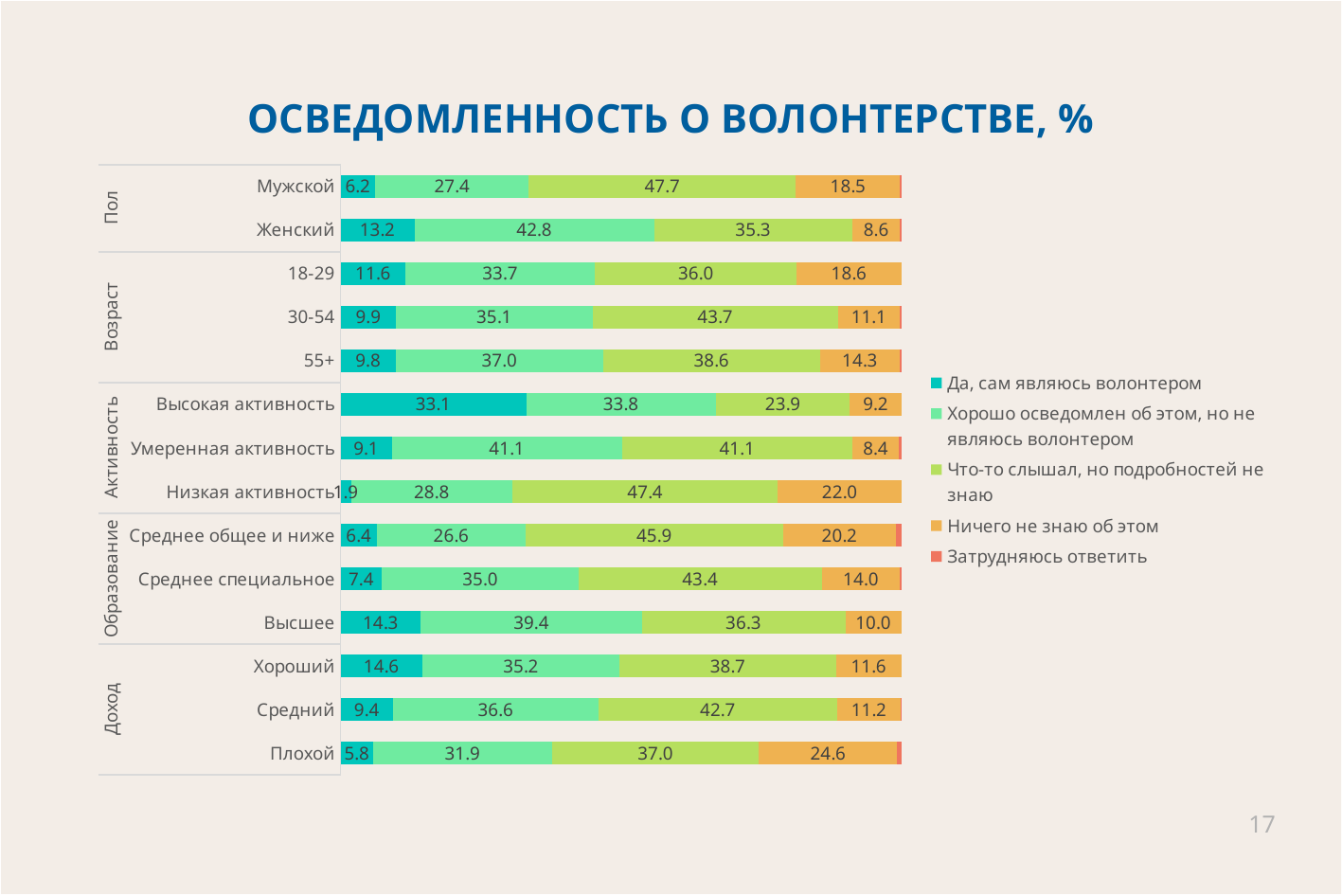
Which category has the lowest value for "Да, сам являюсь волонтером"? Низкая активность Which category has the highest value for "Да, сам являюсь волонтером"? Высокая активность What is the value of "Хорошо осведомлен об этом, но не являюсь волонтером" for "Женский"? 42.8 What kind of chart is shown on the slide? bar chart How many category bars are plotted in the chart? 14 What is the value of "Да, сам являюсь волонтером" for "Высокая активность"? 33.1 How many series does the legend list? 5 What is the value of "Ничего не знаю об этом" for "Плохой"? 24.6 What is the difference between the "Да, сам являюсь волонтером" values for "Женский" and "Мужской"? 7.0 Which category has the highest value for "Ничего не знаю об этом"? Плохой What is the value of "Что-то слышал, но подробностей не знаю" for "Мужской"? 47.7 Which has the larger "Ничего не знаю об этом" value, "18-29" or "55+"? 18-29